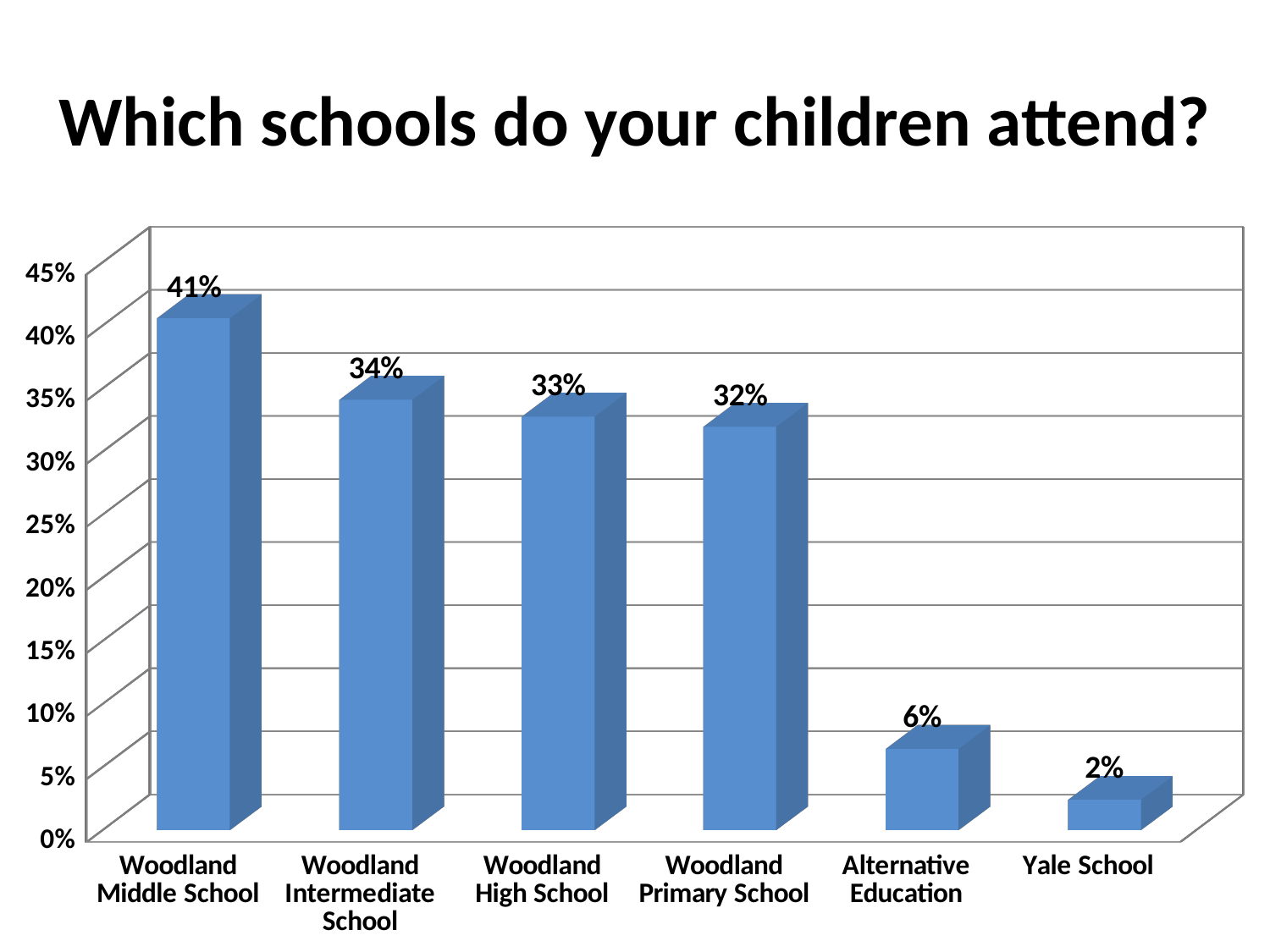
What is the title of the chart? Which schools do your children attend? What is the difference between the values for Woodland Primary School and Alternative Education? 26% How many categories are shown on the chart? 6 What is the value shown for Alternative Education? 6% Which school has the highest percentage of children attending? Woodland Middle School Which is larger, the value for Woodland High School or the value for Alternative Education? Woodland High School What percentage of children attend Woodland Middle School? 41% What percentage is shown for Yale School? 2% What kind of chart is shown on the slide? Bar chart What is the difference between the values for Woodland Middle School and Woodland Intermediate School? 7% Which category has the lowest value on the chart? Yale School Is the value for Woodland Primary School greater or less than 30%? greater